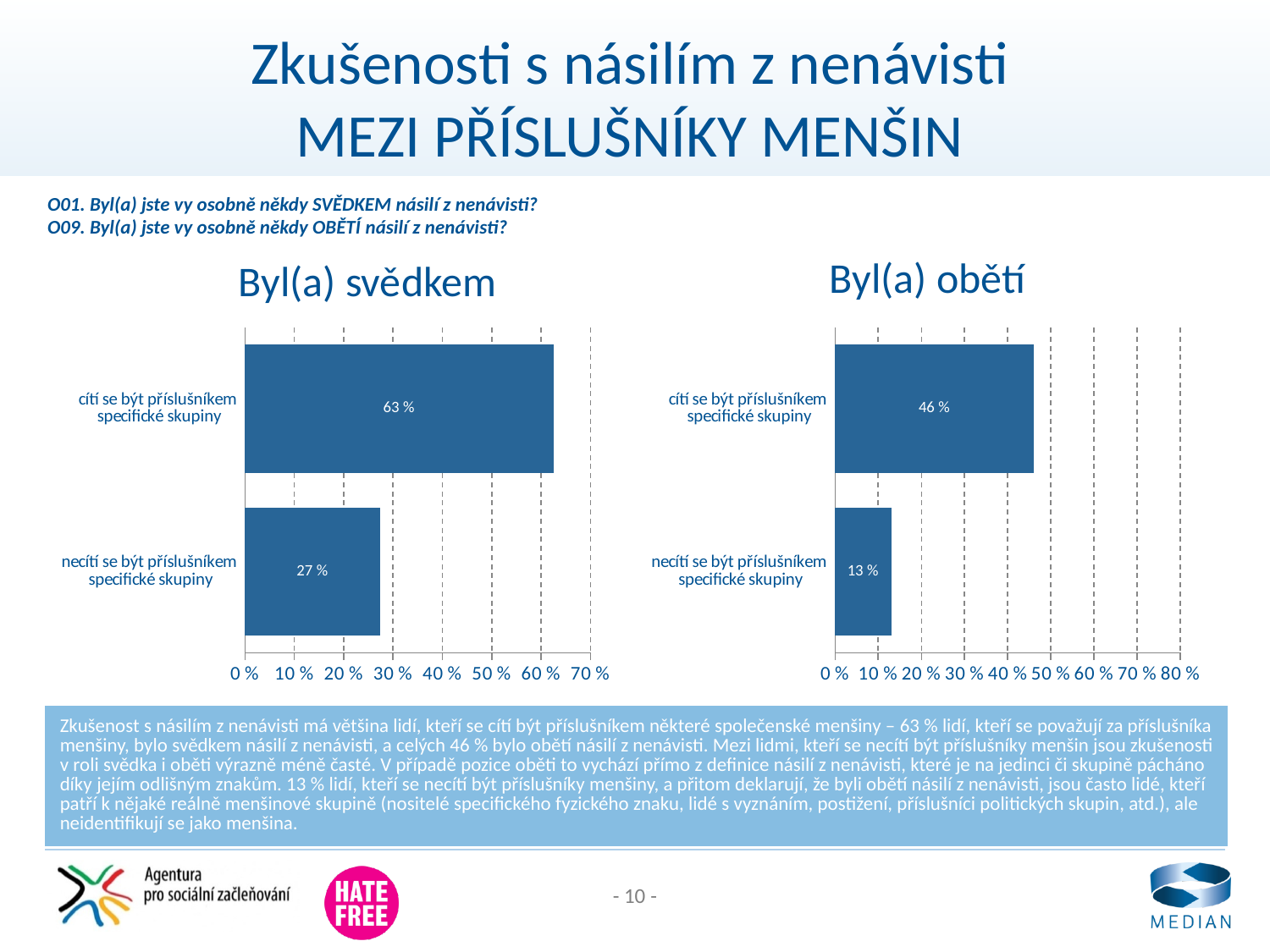
In the 'Byl(a) svědkem' chart, what is the difference between the two categories' values? 36 % In the 'Byl(a) svědkem' chart, which category has the highest value? cítí se být příslušníkem specifické skupiny In the 'Byl(a) obětí' chart, what is the value for 'cítí se být příslušníkem specifické skupiny'? 46 % In the 'Byl(a) obětí' chart, is the value for 'necítí se být příslušníkem specifické skupiny' greater or less than 20 %? less How many categories does the 'Byl(a) svědkem' chart show? 2 In the 'Byl(a) obětí' chart, what is the difference between the two categories' values? 33 % In the 'Byl(a) obětí' chart, what is the value for 'necítí se být příslušníkem specifické skupiny'? 13 % In the 'Byl(a) svědkem' chart, what is the value for 'necítí se být příslušníkem specifické skupiny'? 27 % Which is larger: the value for 'cítí se být příslušníkem specifické skupiny' in the 'Byl(a) svědkem' chart or in the 'Byl(a) obětí' chart? Byl(a) svědkem In the 'Byl(a) svědkem' chart, what is the value for 'cítí se být příslušníkem specifické skupiny'? 63 % In the 'Byl(a) obětí' chart, which category has the lowest value? necítí se být příslušníkem specifické skupiny What type of chart is the 'Byl(a) obětí' chart? bar chart